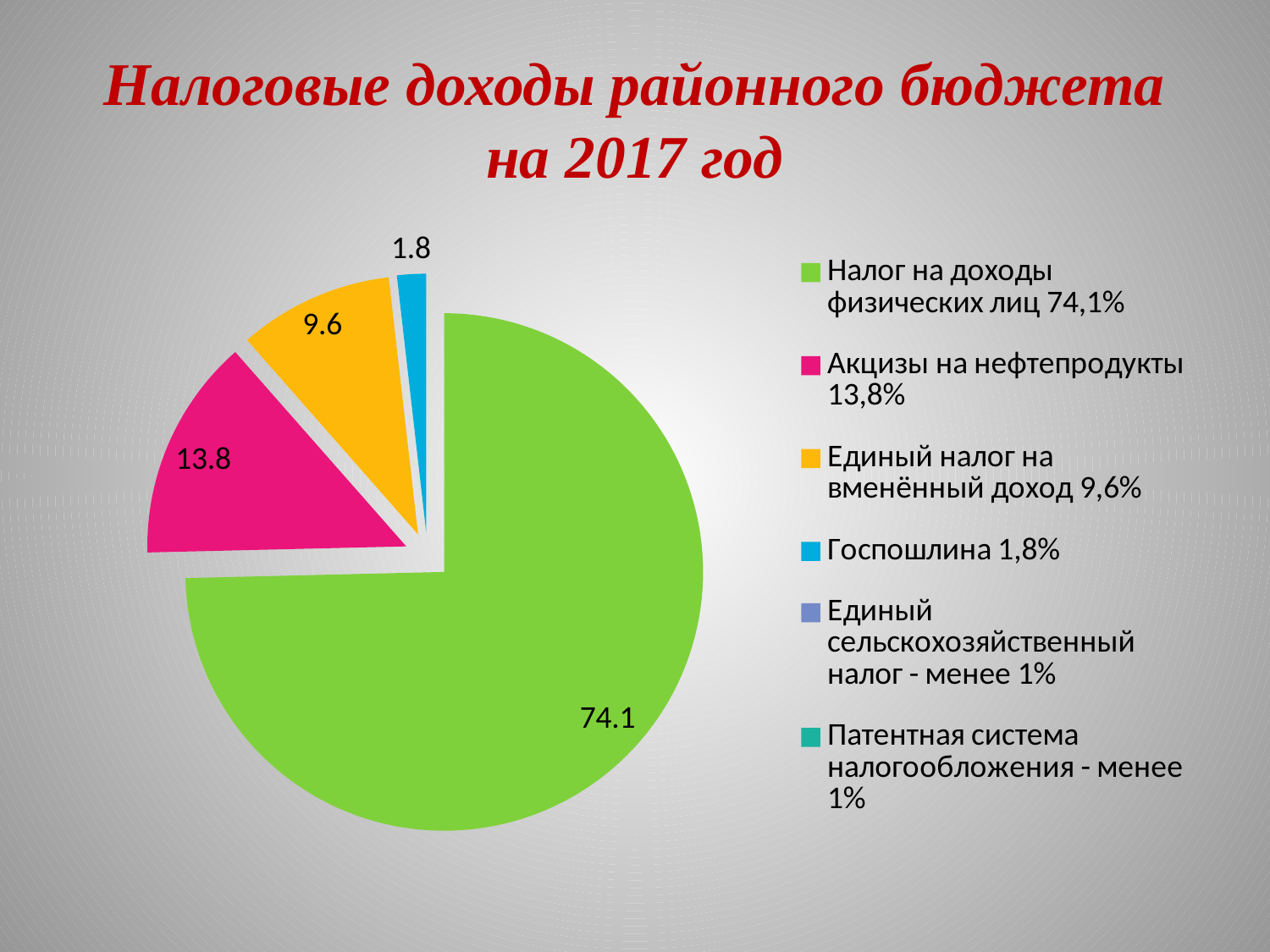
What is the difference between the labelled values for Акцизы на нефтепродукты and Единый налог на вменённый доход? 4.2 What is the difference between the labelled values for Налог на доходы физических лиц and Акцизы на нефтепродукты? 60.3 What value is labelled on the slice for Единый налог на вменённый доход? 9.6 How many entries does the legend list? 6 Which category has the largest slice of the pie? Налог на доходы физических лиц What value is labelled on the slice for Налог на доходы физических лиц? 74.1 Which is larger: the slice for Акцизы на нефтепродукты or the slice for Единый налог на вменённый доход? Акцизы на нефтепродукты What value is labelled on the slice for Акцизы на нефтепродукты? 13.8 What colour is the largest slice of the pie? green What kind of chart is shown on the slide? pie chart What value is labelled on the slice for Госпошлина? 1.8 What is the title of the slide? Налоговые доходы районного бюджета на 2017 год